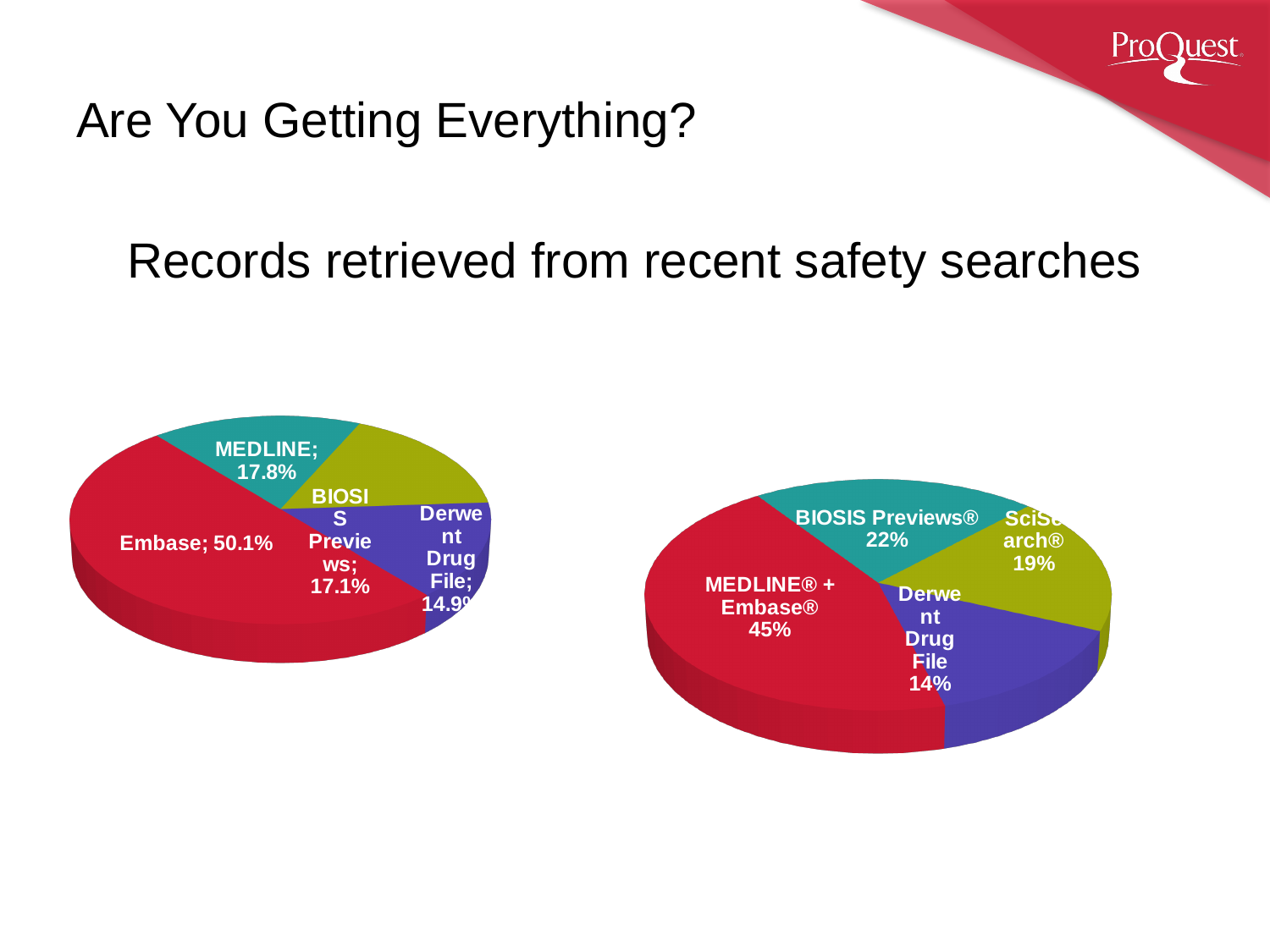
In the right pie chart, what share does MEDLINE® + Embase® have? 45% In the left pie chart, what share does BIOSIS Previews have? 17.1% In the left pie chart, which source has the largest share? Embase In the right pie chart, what share does BIOSIS Previews® have? 22% In the left pie chart, what is the difference between the Embase share and the MEDLINE share? 32.3% How many slices does the left pie chart have? 4 In the left pie chart, which source has the smallest share? Derwent Drug File What type of chart is shown on the left of the slide? Pie chart In the right pie chart, which is larger: the BIOSIS Previews® share or the Derwent Drug File share? BIOSIS Previews® In the left pie chart, what share does Embase have? 50.1% In the left pie chart, what share does MEDLINE have? 17.8% In the right pie chart, which source has the smallest share? Derwent Drug File